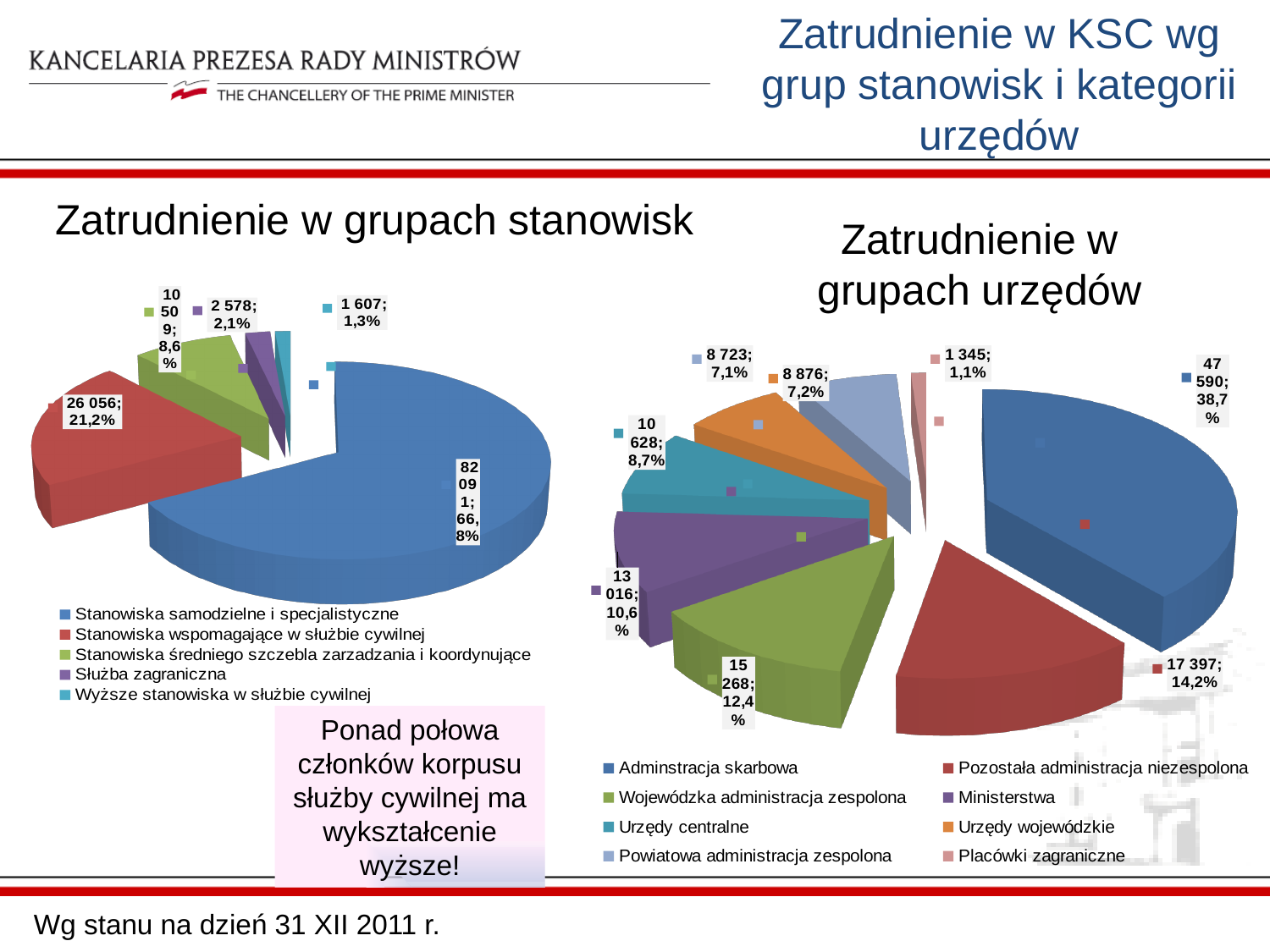
In the chart 'Zatrudnienie w grupach urzędów', what share of the pie is Placówki zagraniczne? 1,1% In the chart 'Zatrudnienie w grupach stanowisk', what value is shown for Stanowiska wspomagające w służbie cywilnej? 26 056; 21,2% What type of chart is 'Zatrudnienie w grupach urzędów'? Pie chart In the chart 'Zatrudnienie w grupach stanowisk', what share of the pie is Stanowiska samodzielne i specjalistyczne? 66,8% In the chart 'Zatrudnienie w grupach urzędów', which category has the largest slice? Adminstracja skarbowa In the chart 'Zatrudnienie w grupach stanowisk', how many categories does the legend list? 5 In the chart 'Zatrudnienie w grupach urzędów', what colour is the slice for Wojewódzka administracja zespolona? Green In the chart 'Zatrudnienie w grupach urzędów', how many categories does the legend list? 8 In the chart 'Zatrudnienie w grupach stanowisk', which category has the smallest slice? Wyższe stanowiska w służbie cywilnej In the chart 'Zatrudnienie w grupach urzędów', which is larger: Urzędy centralne or Urzędy wojewódzkie? Urzędy centralne In the chart 'Zatrudnienie w grupach stanowisk', what is the difference between the values for Stanowiska średniego szczebla zarzadzania i koordynujące and Służba zagraniczna? 7 931 In the chart 'Zatrudnienie w grupach urzędów', what value is shown for Ministerstwa? 13 016; 10,6%